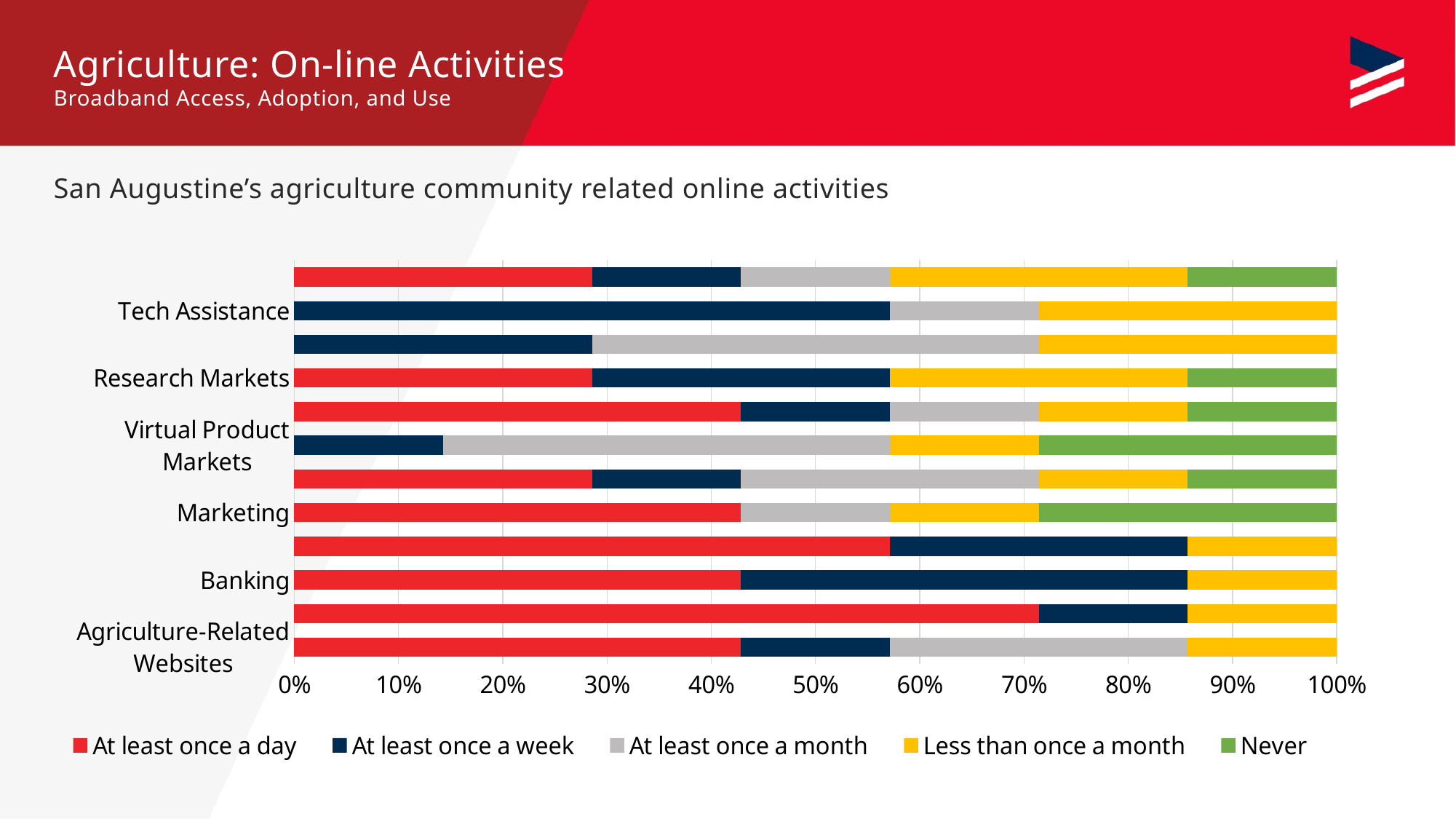
Is the "At least once a week" share for Banking greater or less than 30%? greater Which has the larger "At least once a week" share, Tech Assistance or Virtual Product Markets? Tech Assistance Is the "At least once a week" share for Virtual Product Markets greater or less than 20%? less What kind of chart is shown on the slide? Stacked bar chart Is the "Never" share for Virtual Product Markets greater or less than 20%? greater Which colour represents "Never" in the legend? Green How many series does the legend list? 5 What is the highest value shown on the x axis? 100%